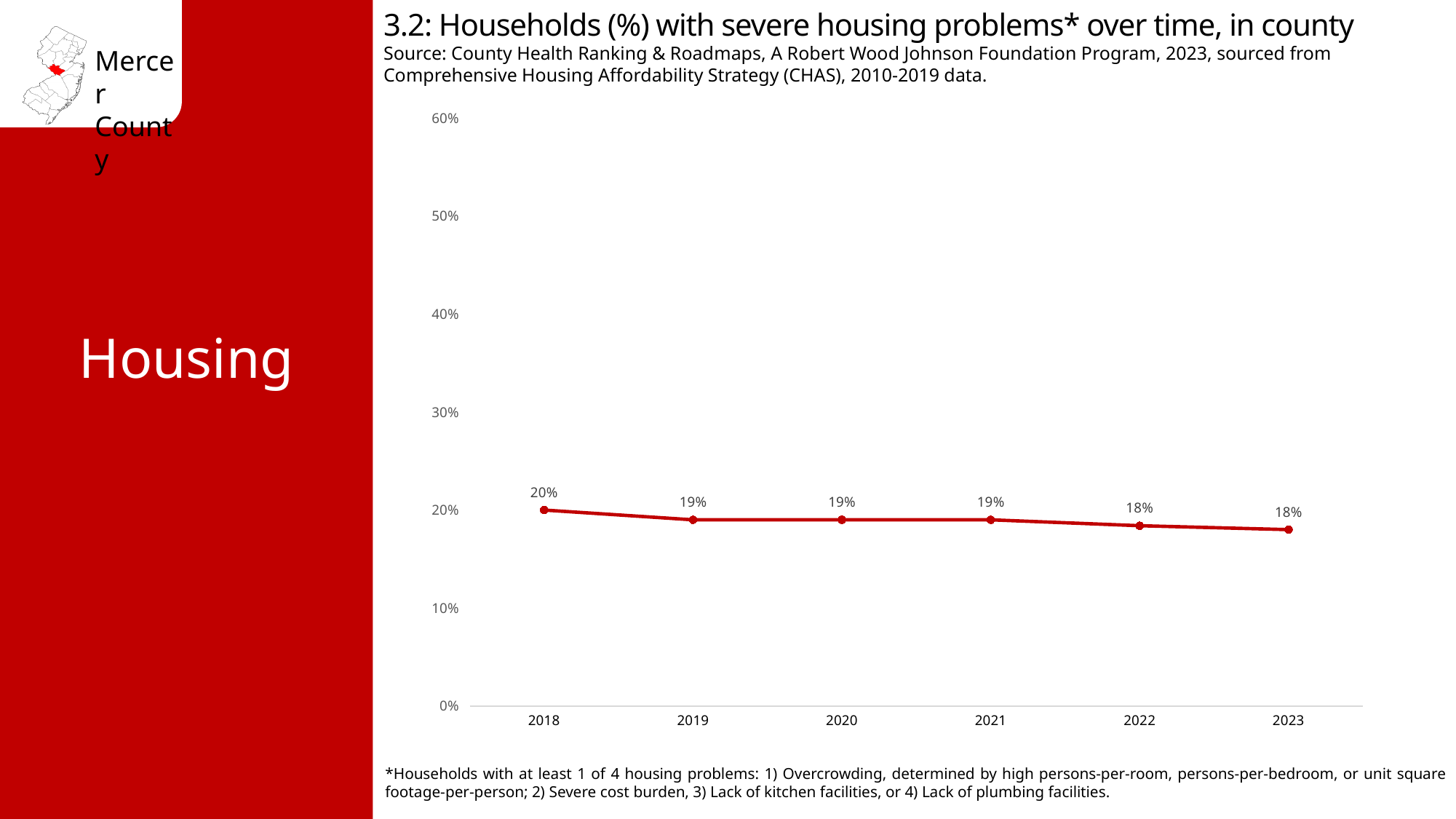
Is the value for 2020 greater or less than 30%? less How many years are plotted on the chart? 6 Do the values rise or fall from 2018 to 2023? fall What is the title of the chart? 3.2: Households (%) with severe housing problems* over time, in county Which year has the highest value on the chart? 2018 Is the value for 2018 greater or less than the value for 2022? greater What kind of chart is shown on the slide? line chart What is the value shown for 2021? 19% What is the difference between the 2018 value and the 2023 value? 2% What is the highest value shown on the y axis? 60% What percentage of households had severe housing problems in 2023? 18% What percentage of households had severe housing problems in 2018? 20%